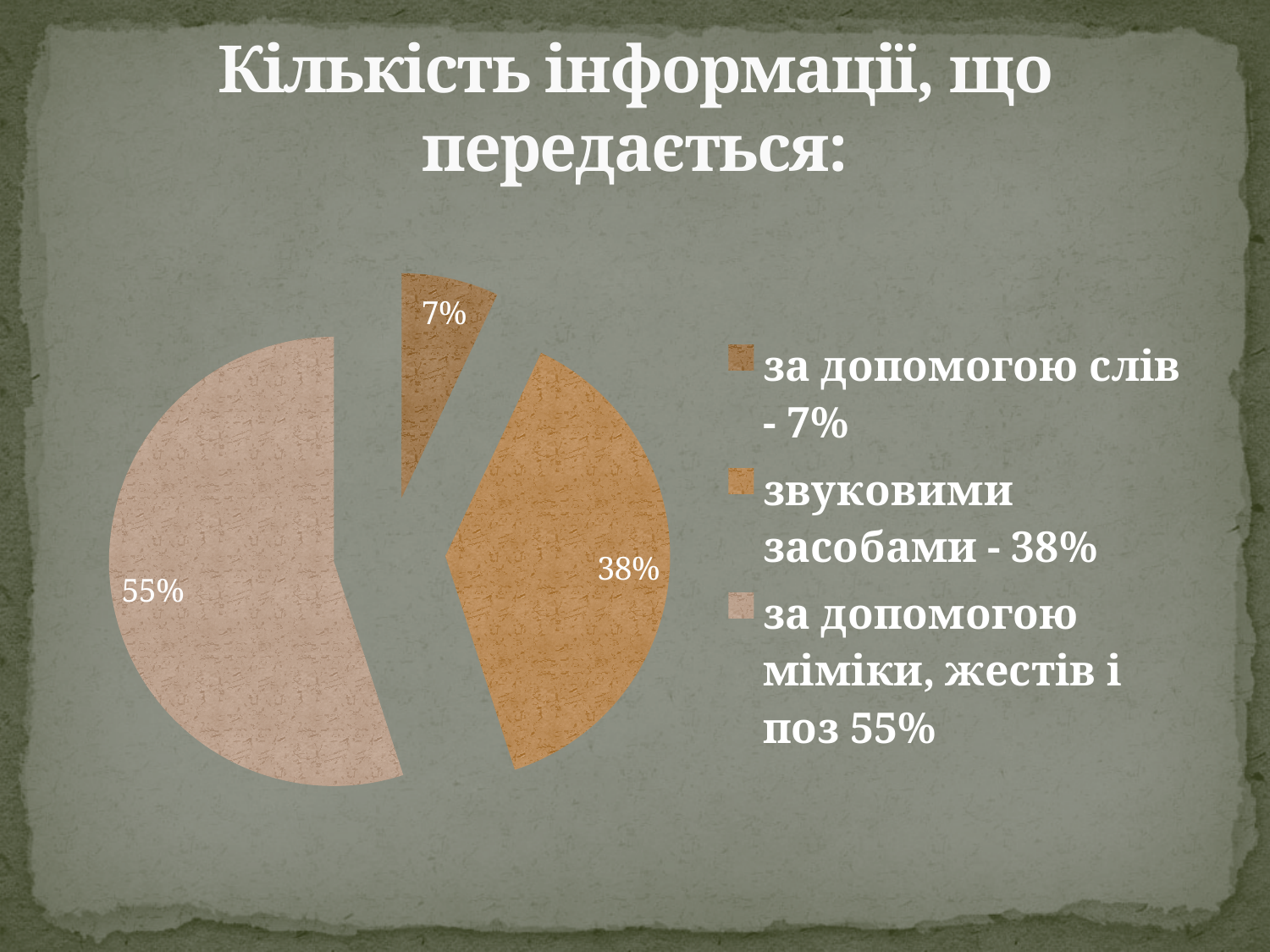
Which category has the largest slice of the pie? за допомогою міміки, жестів і поз What is the difference in percentage points between the 'за допомогою міміки, жестів і поз' slice and the 'звуковими засобами' slice? 17 What share of the pie is labelled for 'за допомогою міміки, жестів і поз'? 55% What is the difference in percentage points between the 'звуковими засобами' slice and the 'за допомогою слів' slice? 31 What share of the pie is labelled for 'за допомогою слів'? 7% Which category has the smallest slice of the pie? за допомогою слів How many slices does the pie chart have? 3 How many entries does the legend list? 3 What is the title of the chart slide? Кількість інформації, що передається: What share of the pie is labelled for 'звуковими засобами'? 38% What kind of chart is shown on the slide? pie chart Which is larger, the slice for 'звуковими засобами' or the slice for 'за допомогою слів'? звуковими засобами